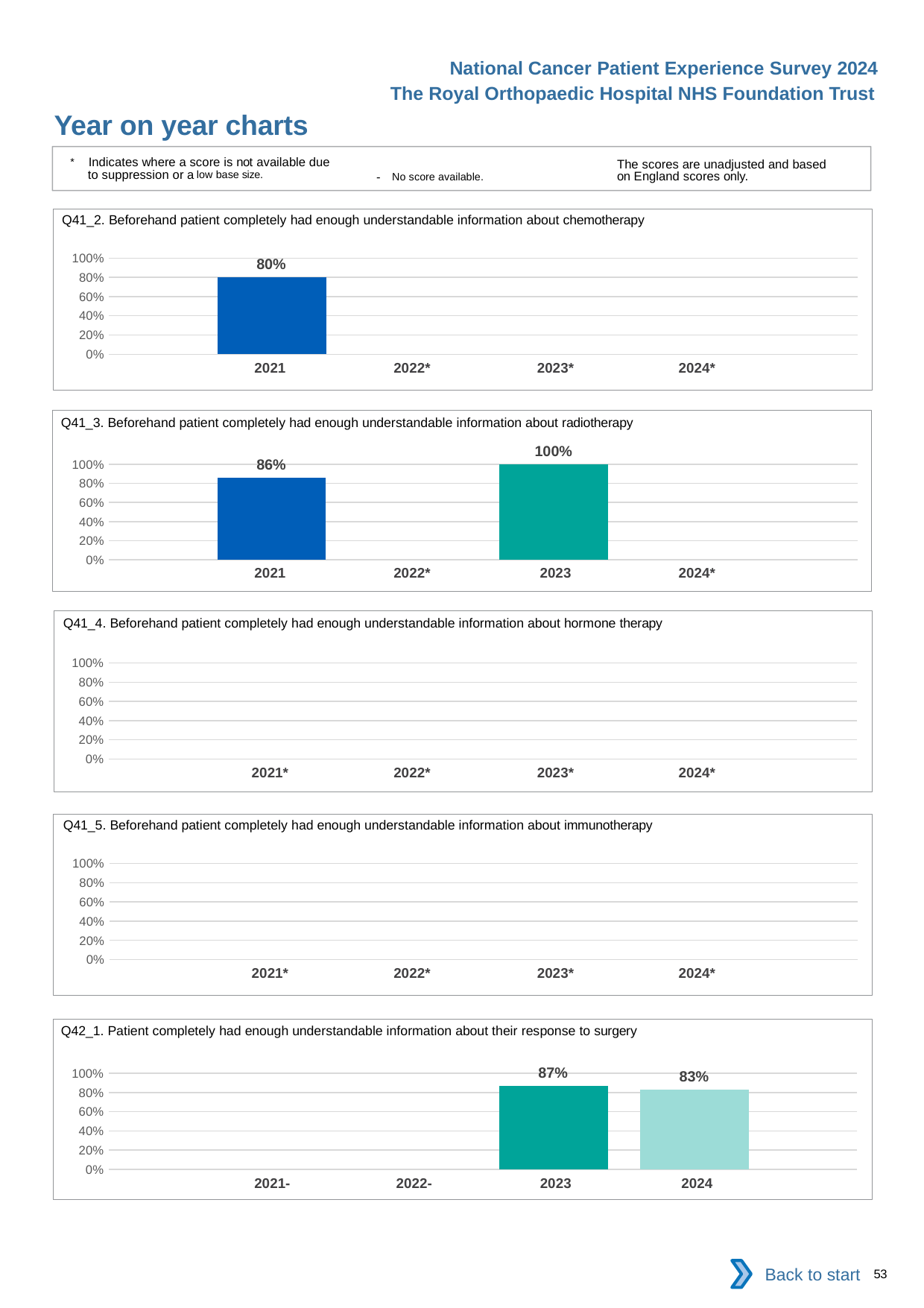
In the Q42_1 chart about response to surgery, which year has the highest value? 2023 In the Q42_1 chart about response to surgery, what is the value for 2024? 83% In the Q42_1 chart about response to surgery, what is the difference between the 2023 and 2024 values? 4% In the Q42_1 chart about response to surgery, do the values rise or fall from 2023 to 2024? fall In the Q41_3 chart about radiotherapy, what is the value for 2021? 86% What kind of chart is the Q41_2 chart about chemotherapy? bar chart In the Q41_3 chart about radiotherapy, what is the value for 2023? 100% How many year categories are shown on the x axis of the Q41_4 chart about hormone therapy? 4 In the Q41_3 chart about radiotherapy, which year has the higher value, 2021 or 2023? 2023 In the Q41_2 chart about chemotherapy, what is the value for 2021? 80% In the Q41_3 chart about radiotherapy, what is the difference between the 2023 and 2021 values? 14% In the Q42_1 chart about response to surgery, what is the value for 2023? 87%